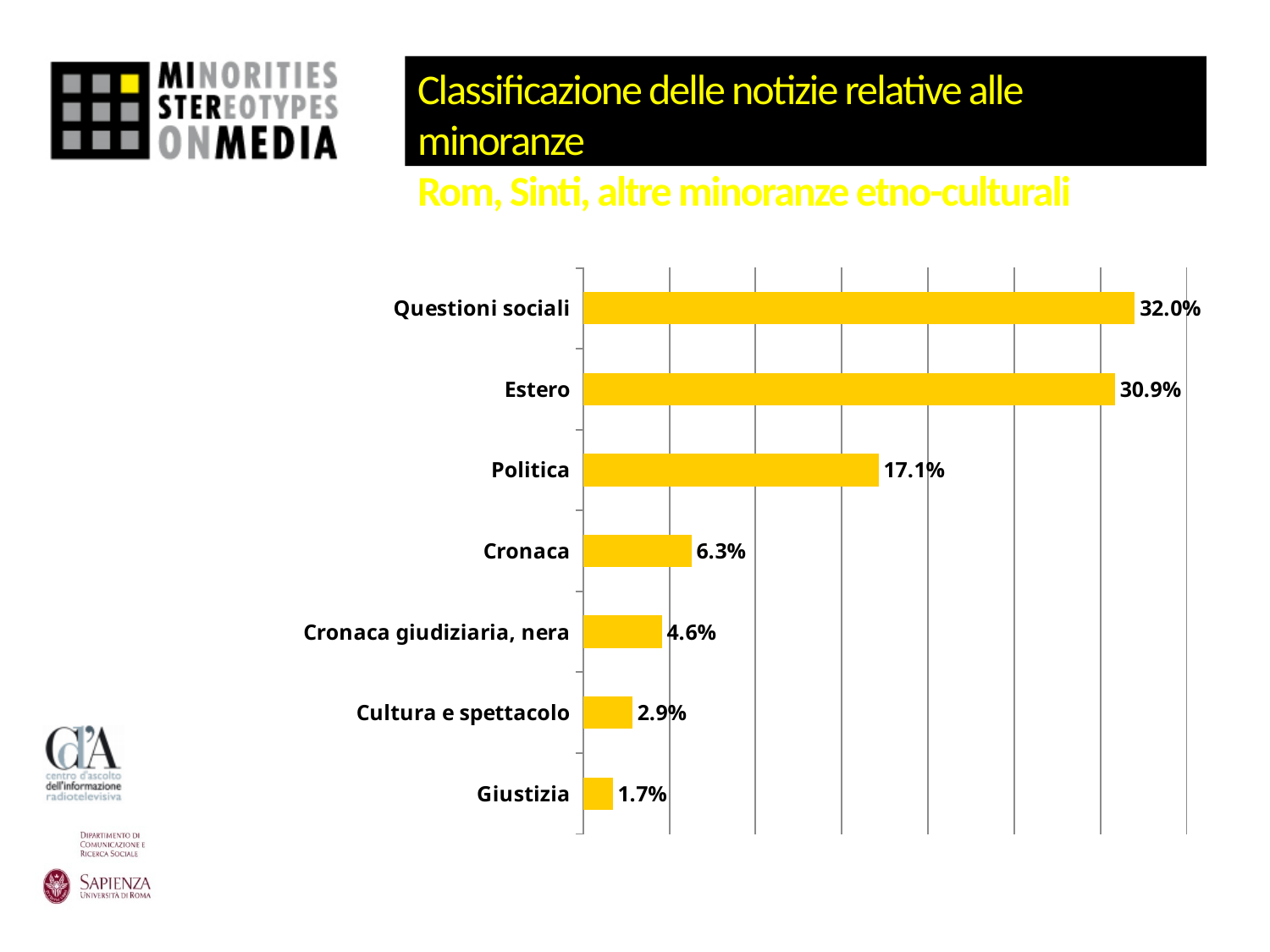
What is the difference between the values for Cronaca and Cultura e spettacolo? 3.4% Which category has the lowest value? Giustizia What is the value for Cronaca giudiziaria, nera? 4.6% What is the difference between the values for Estero and Politica? 13.8% How many categories are shown in the chart? 7 What is the subtitle shown in yellow above the chart? Rom, Sinti, altre minoranze etno-culturali Which category has the highest value? Questioni sociali What kind of chart is shown on the slide? Bar chart What is the value for Questioni sociali? 32.0% Which is larger, the value for Cronaca or the value for Cronaca giudiziaria, nera? Cronaca What is the value for Politica? 17.1% What is the value for Giustizia? 1.7%